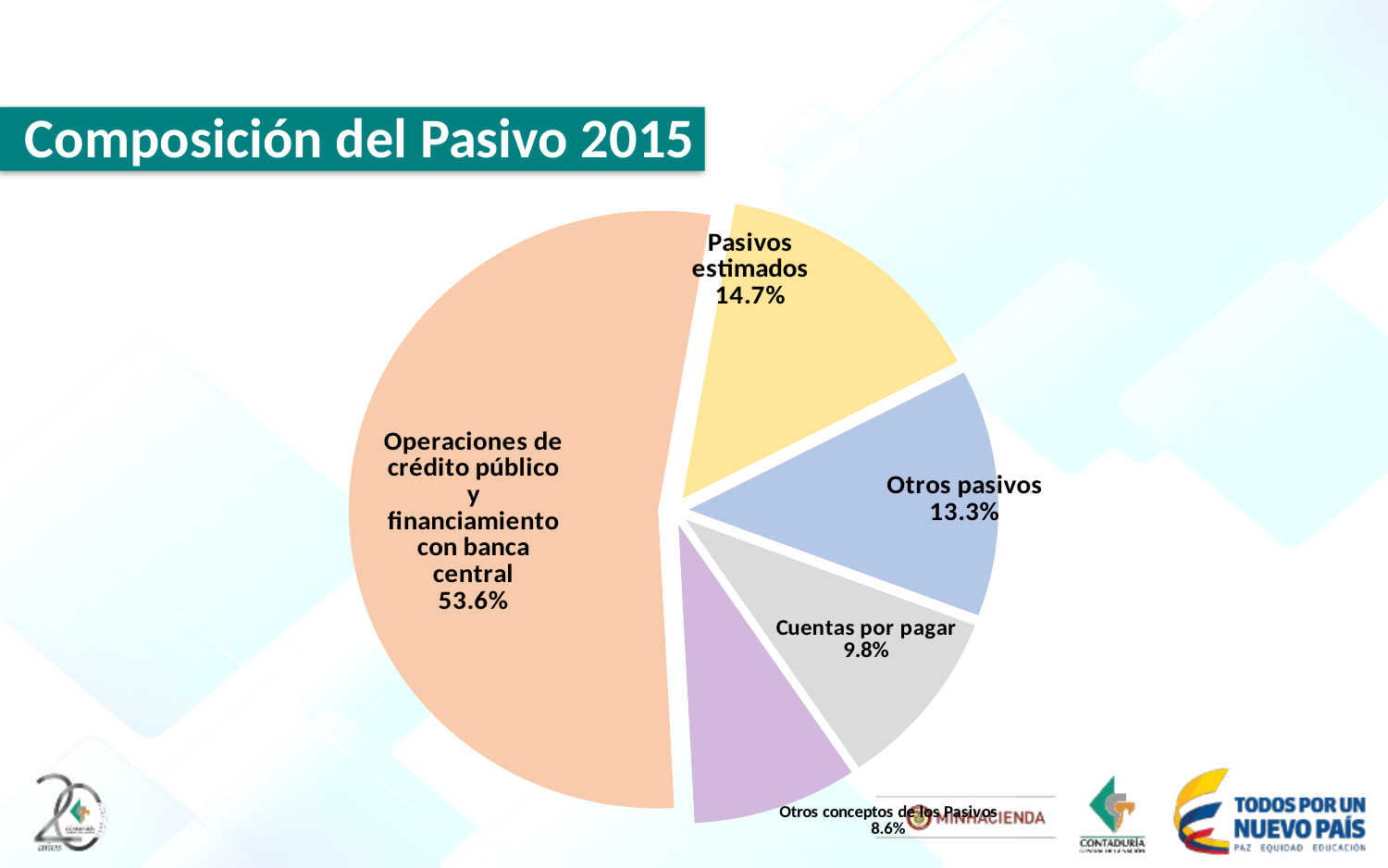
What is the title of the chart? Composición del Pasivo 2015 Which is larger, the share for 'Cuentas por pagar' or the share for 'Otros conceptos de los Pasivos'? Cuentas por pagar What share of the pie is 'Otros pasivos'? 13.3% How many slices does the pie chart have? 5 What share of the pie is 'Pasivos estimados'? 14.7% Which category has the largest share of the pie? Operaciones de crédito público y financiamiento con banca central What is the difference in percentage points between 'Pasivos estimados' and 'Otros pasivos'? 1.4 Which category has the smallest share of the pie? Otros conceptos de los Pasivos What share of the pie is 'Cuentas por pagar'? 9.8% What share of the pie is 'Otros conceptos de los Pasivos'? 8.6% What kind of chart is shown on the slide? Pie chart What share of the pie is 'Operaciones de crédito público y financiamiento con banca central'? 53.6%